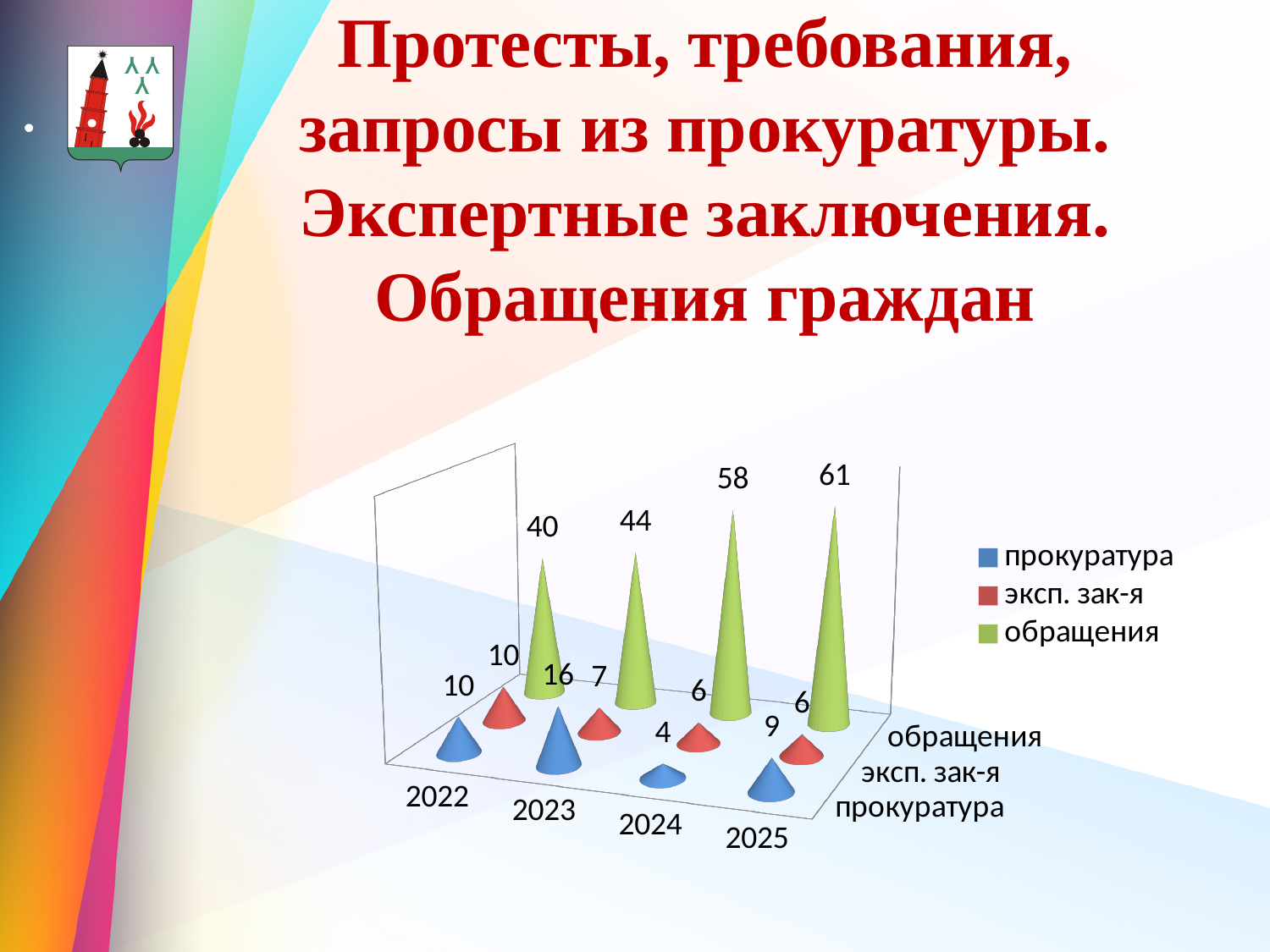
Do the обращения values rise or fall from 2022 to 2025? rise What is the value for эксп. зак-я in 2022? 10 In which year is the value for обращения highest? 2025 How many years are shown on the x axis? 4 Which colour represents the обращения series in the legend? green Which is larger, the прокуратура value for 2023 or for 2025? 2023 In which year is the value for прокуратура lowest? 2024 How many series does the legend list? 3 What is the value for прокуратура in 2023? 16 What is the value for прокуратура in 2024? 4 What is the difference between the обращения values for 2025 and 2022? 21 What is the value for обращения in 2025? 61